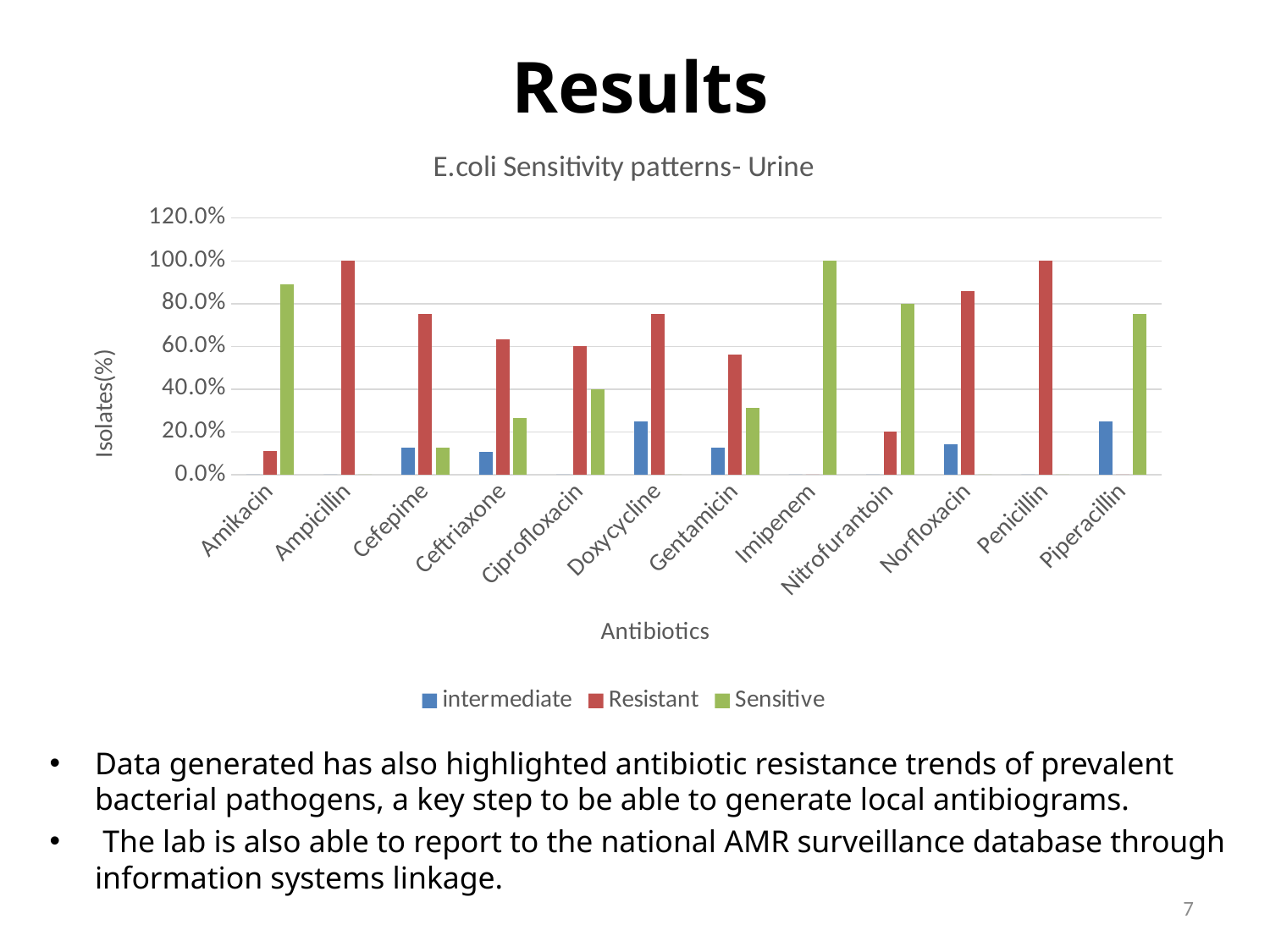
What is the title of the chart? E.coli Sensitivity patterns- Urine How many antibiotics are shown on the x axis? 12 What is the Resistant value for Ampicillin? 100.0% What is the Sensitive value for Nitrofurantoin? 80.0% For Ceftriaxone, which is larger: the Resistant value or the Sensitive value? Resistant What type of chart is shown on the slide? bar chart Is the Sensitive value for Amikacin greater or less than 80.0%? greater Which antibiotic has the highest Sensitive value? Imipenem What is the Resistant value for Ciprofloxacin? 60.0% Is the Resistant value for Gentamicin greater or less than 40.0%? greater What is the Sensitive value for Imipenem? 100.0% How many series does the legend list? 3